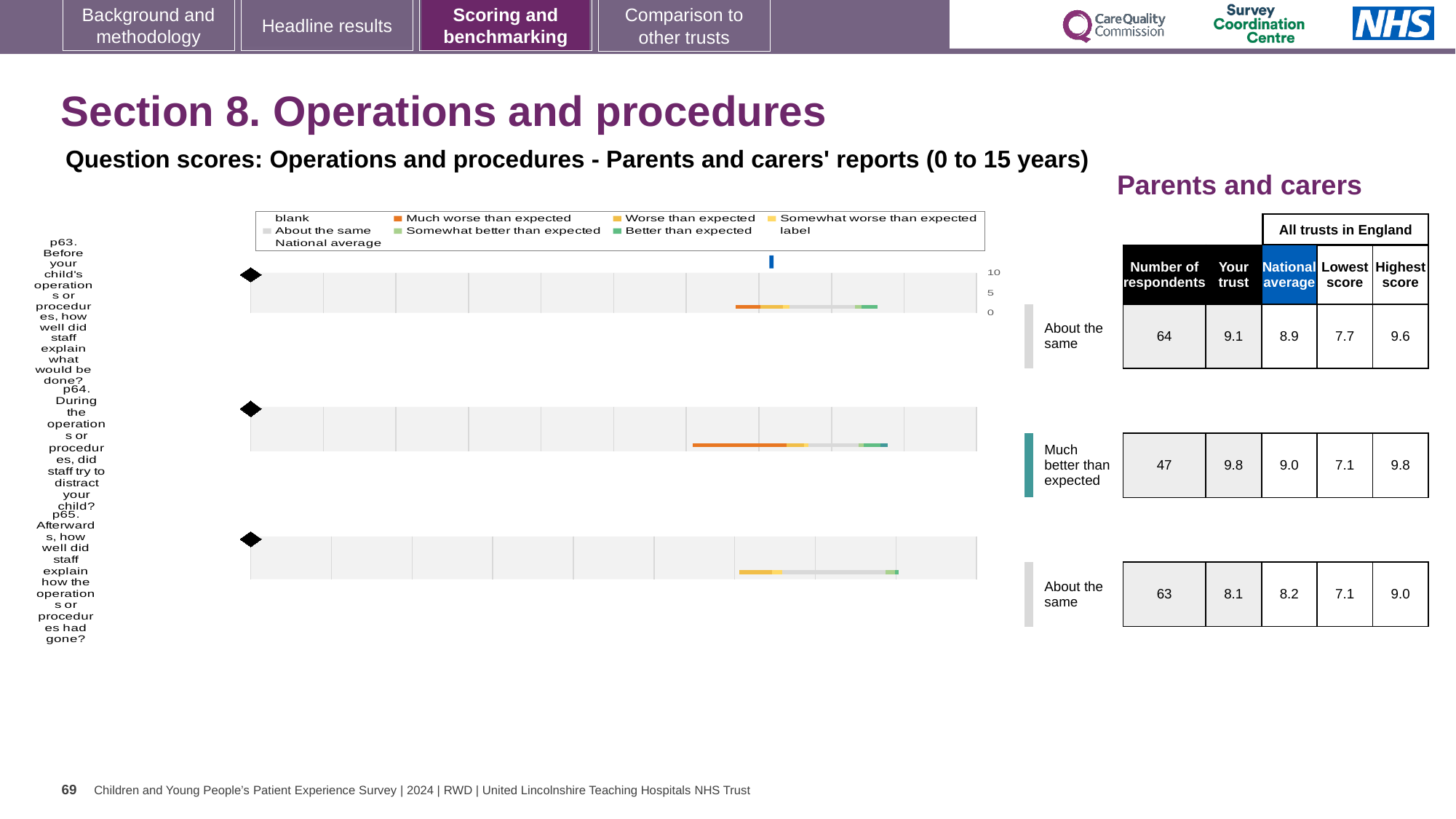
Which question has the highest 'Your trust' score in the table? p64 For p63, what is the difference between the Highest score and the Lowest score in the table? 1.9 How many questions (p63, p64, p65) are charted on this slide? 3 In the table beside the charts, what is the Lowest score for p65? 7.1 In the table beside the charts, what is the National average for p64 (did staff try to distract your child)? 9.0 In the table beside the charts, how many respondents answered p65 (how well staff explained how the operation had gone)? 63 Which question has the lowest 'Your trust' score in the table? p65 What kind of chart is used to show the question scores on this slide? bar chart In the table beside the charts, what is the 'Your trust' score for p63 (how well staff explained what would be done before the operation)? 9.1 What is the highest tick value shown on the axis of the top chart? 10 For p64, which is larger: the 'Your trust' score or the National average? Your trust What benchmark category label is shown next to the chart for p64? Much better than expected